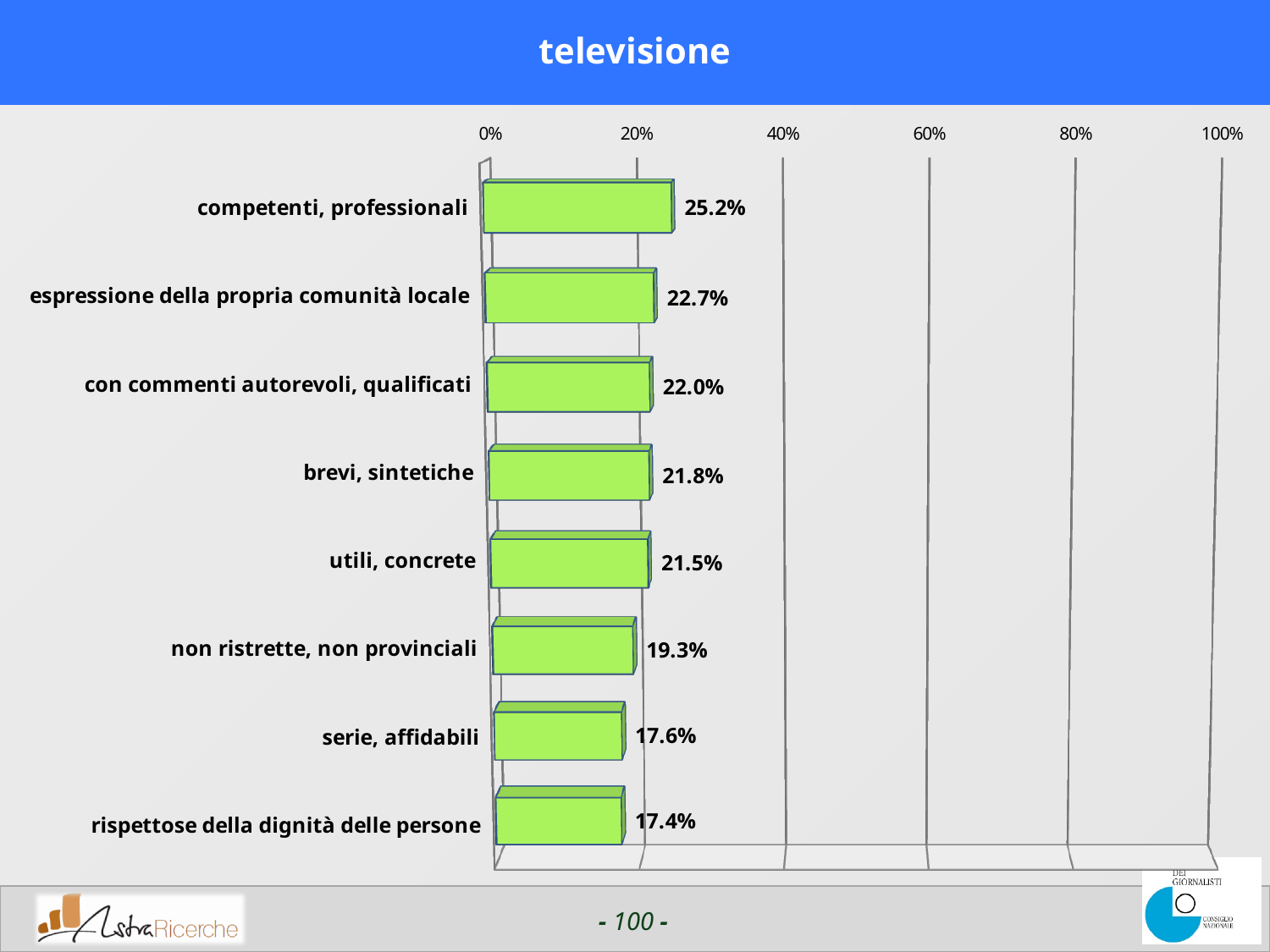
Which category has the lowest value? rispettose della dignità delle persone Is the value for "con commenti autorevoli, qualificati" greater or less than 40%? less Which category has the highest value? competenti, professionali What is the value for "non ristrette, non provinciali"? 19.3% Which is larger, the value for "espressione della propria comunità locale" or the value for "utili, concrete"? espressione della propria comunità locale What is the value for "competenti, professionali"? 25.2% What is the title of the chart? televisione What kind of chart is shown on the slide? bar chart How many categories are shown in the chart? 8 What is the value for "rispettose della dignità delle persone"? 17.4% What is the difference between the values for "competenti, professionali" and "serie, affidabili"? 7.6% What is the value for "brevi, sintetiche"? 21.8%